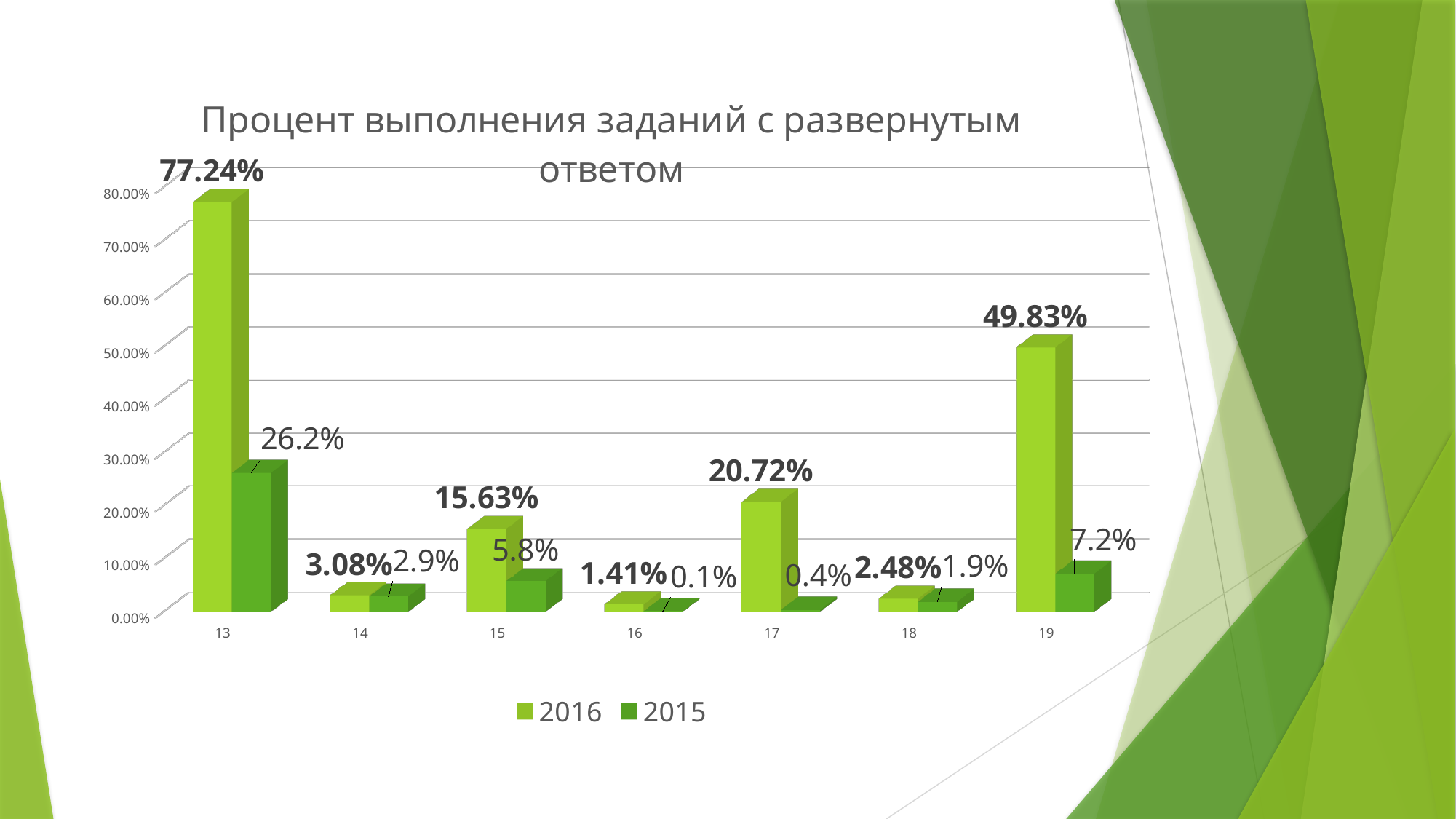
What kind of chart is shown on the slide? Bar chart What is the title of the chart? Процент выполнения заданий с развернутым ответом Which category has the lowest value in the 2015 series? 16 What is the difference between the 2016 and 2015 values for category 13? 51.04 percentage points What is the value for category 13 in the 2016 series? 77.24% How many categories are shown on the x axis? 7 What is the value for category 19 in the 2015 series? 7.2% Which category has the highest value in the 2016 series? 13 What is the value for category 16 in the 2015 series? 0.1% What is the value for category 17 in the 2016 series? 20.72% Which is larger for category 15: the 2016 value or the 2015 value? 2016 How many series does the legend list? 2